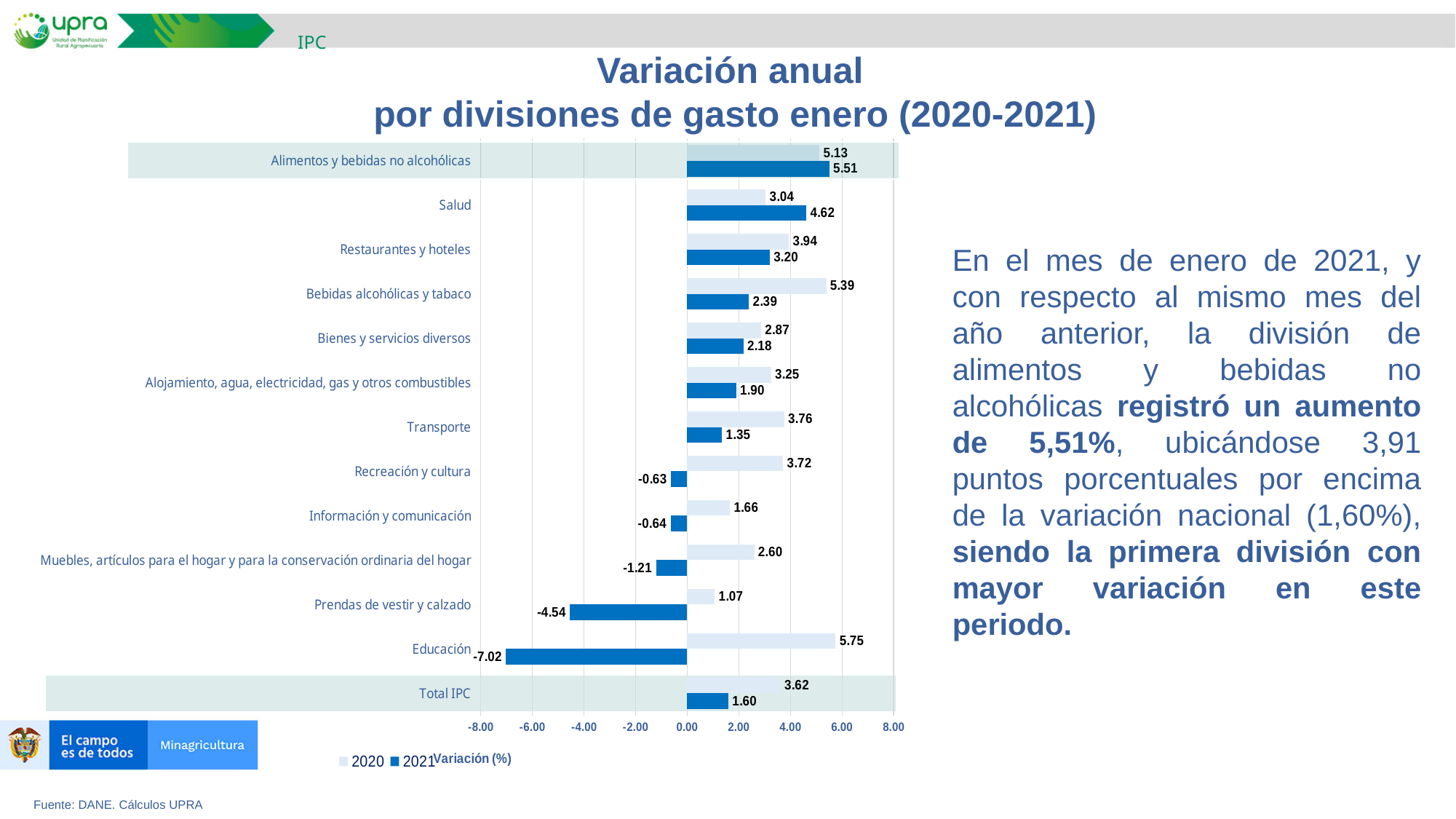
How many series does the legend list? 2 Which category has the lowest 2021 value? Educación What is the 2020 value for Educación? 5.75 What type of chart is shown on the slide? bar chart What is the difference between the 2021 value for Alimentos y bebidas no alcohólicas and the 2021 value for Total IPC? 3.91 How many categories are plotted on the chart? 13 What is the 2021 value for Salud? 4.62 What is the difference between the 2021 and 2020 values for Salud? 1.58 What is the 2021 value for Prendas de vestir y calzado? -4.54 For Restaurantes y hoteles, which series has the larger value, 2020 or 2021? 2020 Which category has the highest 2021 value? Alimentos y bebidas no alcohólicas What are the two entries in the chart legend? 2020 and 2021